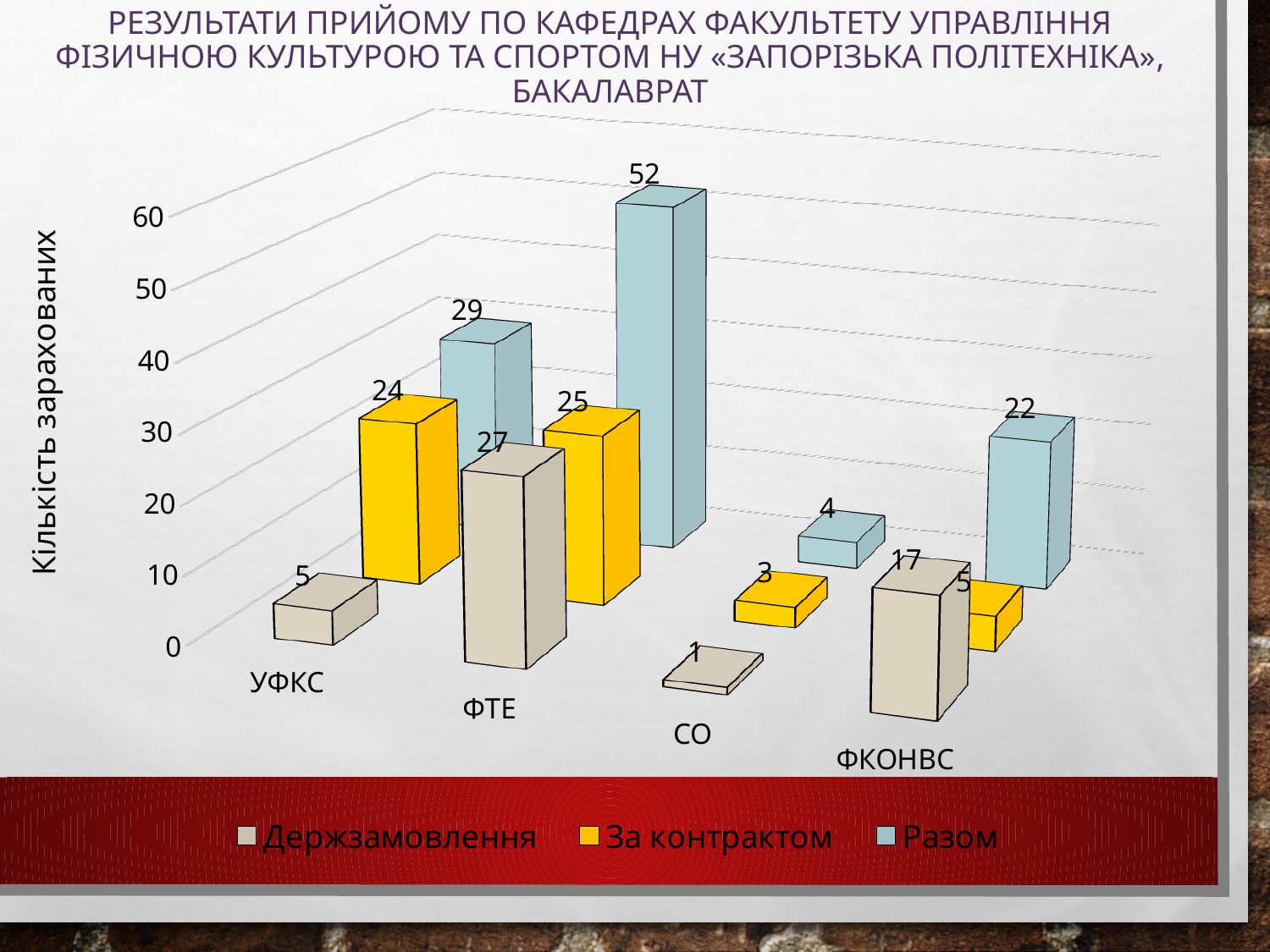
Which category has the highest Разом value? ФТЕ What is the value of Держзамовлення for ФКОНВС? 17 How many categories are shown on the x axis? 4 What is the value of Разом for ФТЕ? 52 What is the value of За контрактом for УФКС? 24 What is the label of the vertical axis? Кількість зарахованих Which category has the lowest Держзамовлення value? СО Which is larger: Держзамовлення for ФТЕ or За контрактом for ФТЕ? Держзамовлення for ФТЕ What is the value of Держзамовлення for СО? 1 How many series does the legend list? 3 What is the difference between the Разом values for ФТЕ and УФКС? 23 What kind of chart is shown on the slide? bar chart